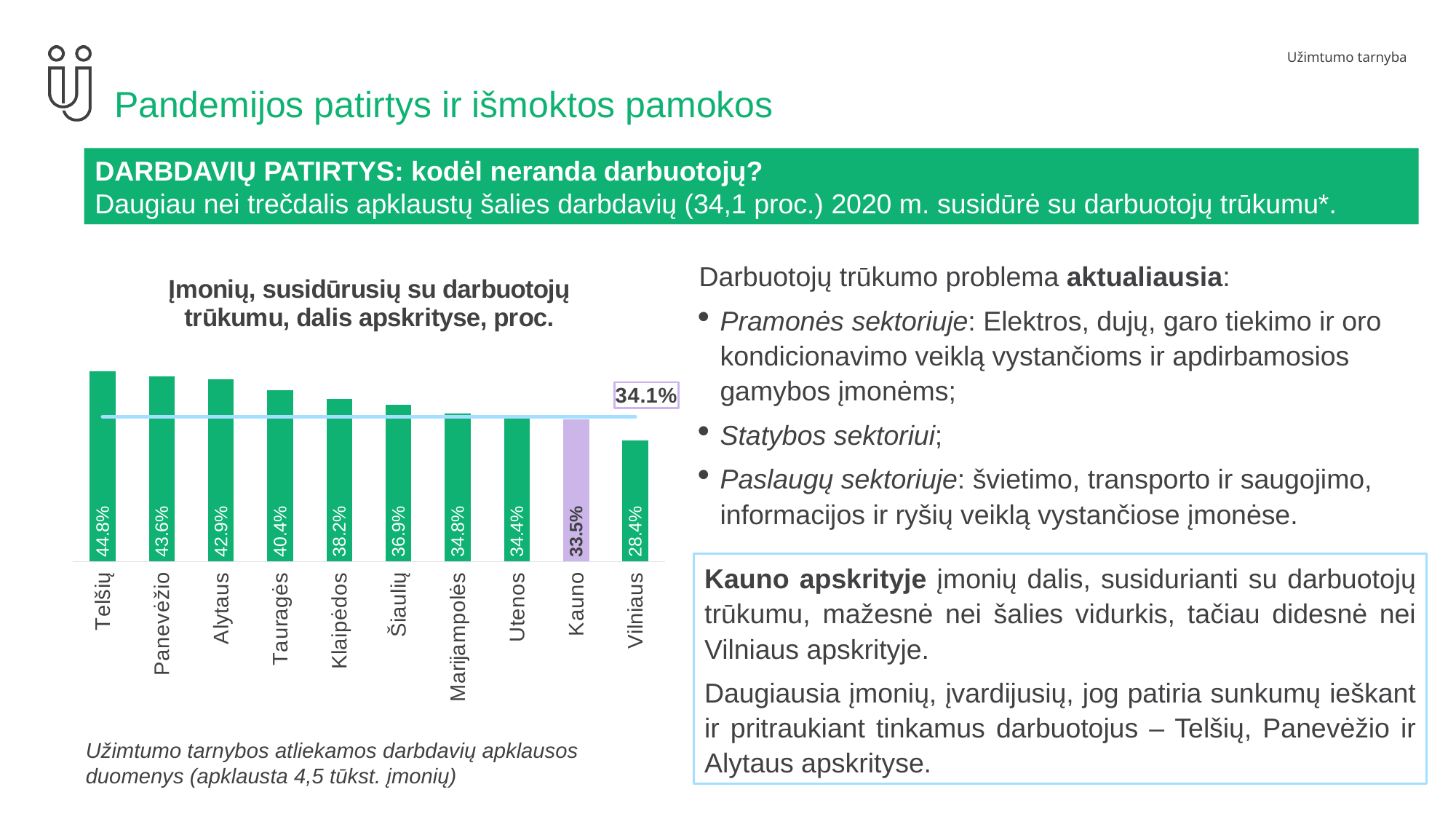
What is the value for Telšių in the chart? 44.8% What is the difference between the values for Telšių and Vilniaus? 16.4 percentage points What kind of chart is shown on the slide? Bar chart What value is marked by the horizontal line across the chart? 34.1% Do the bar values rise or fall from left to right across the chart? Fall Which bar in the chart is coloured differently (purple) from the others? Kauno What is the value for Vilniaus in the chart? 28.4% How many counties (categories) are shown in the chart? 10 Which county (apskritis) has the highest value in the chart? Telšių Which has a larger value, Alytaus or Tauragės? Alytaus Which county (apskritis) has the lowest value in the chart? Vilniaus What is the value for Kauno in the chart? 33.5%